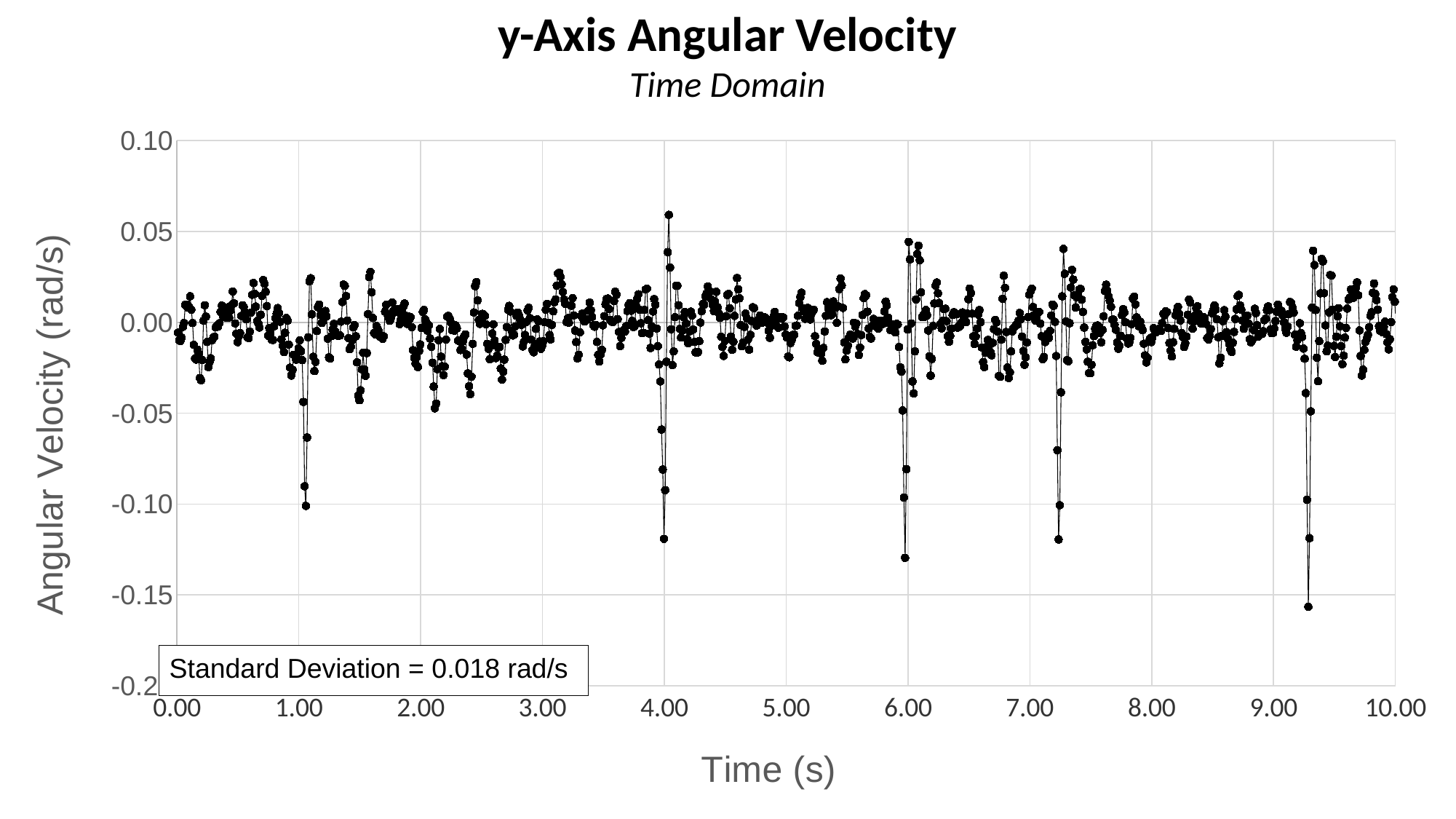
Is the large negative spike near 1.0 s greater or less than -0.05 rad/s? less Is the large negative spike near 6.0 s greater or less than -0.10 rad/s? less What standard deviation value is printed in the annotation box on the chart? 0.018 rad/s Is the highest angular velocity value on the chart, near 4.0 s, greater or less than 0.05 rad/s? greater What is the maximum value shown on the y axis? 0.10 Which negative spike reaches a lower value: the one near 6.0 s or the one near 7.2 s? The one near 6.0 s What is the title of the chart? y-Axis Angular Velocity What is the label of the x axis? Time (s) What kind of chart is shown on the slide? Line chart with markers (time series)